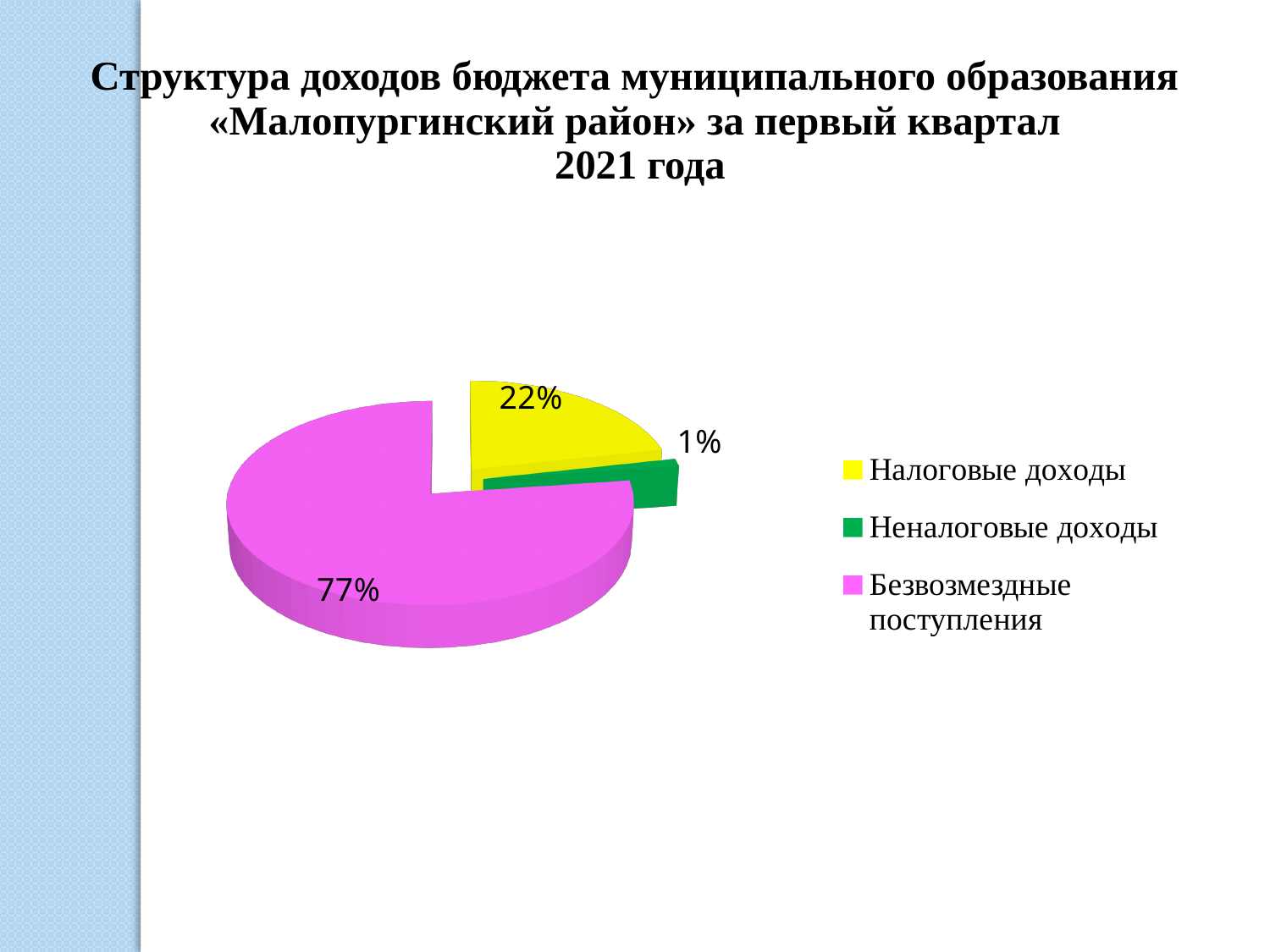
How many slices does the pie chart have? 3 What colour is the slice for Безвозмездные поступления? Pink What share of the pie does Налоговые доходы have? 22% How many entries does the legend list? 3 Which is larger, the share of Налоговые доходы or the share of Неналоговые доходы? Налоговые доходы Which category has the largest slice of the pie? Безвозмездные поступления What kind of chart is shown on the slide? Pie chart What is the difference between the shares of Безвозмездные поступления and Налоговые доходы? 55% What share of the pie does Безвозмездные поступления have? 77% Which category has the smallest slice of the pie? Неналоговые доходы What colour is the slice for Налоговые доходы? Yellow What share of the pie does Неналоговые доходы have? 1%